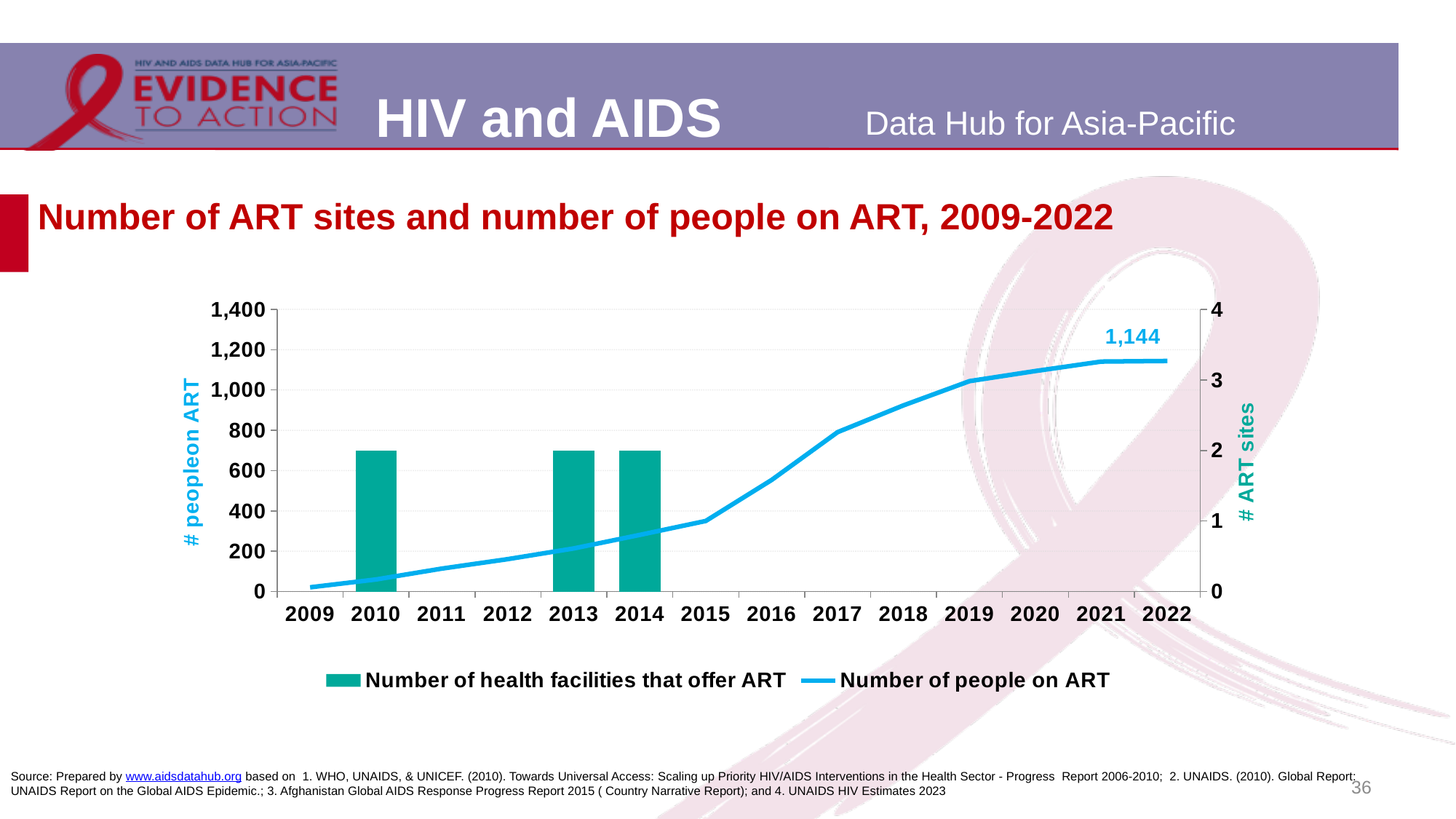
Is the number of people on ART in 2011 greater or less than 200? less Which series is plotted as a line? Number of people on ART What is the title of the chart? Number of ART sites and number of people on ART, 2009-2022 What is the number of health facilities that offer ART in 2010? 2 How many years have a bar for 'Number of health facilities that offer ART'? 3 How many years are shown on the x axis? 14 What is the data label shown on the 'Number of people on ART' line at the end of the series? 1,144 What is the number of health facilities that offer ART in 2013? 2 What kind of chart is this? Combination bar and line chart Does the number of people on ART rise or fall from 2009 to 2022? Rise How many series does the legend list? 2 Is the number of people on ART in 2017 greater or less than 600? greater